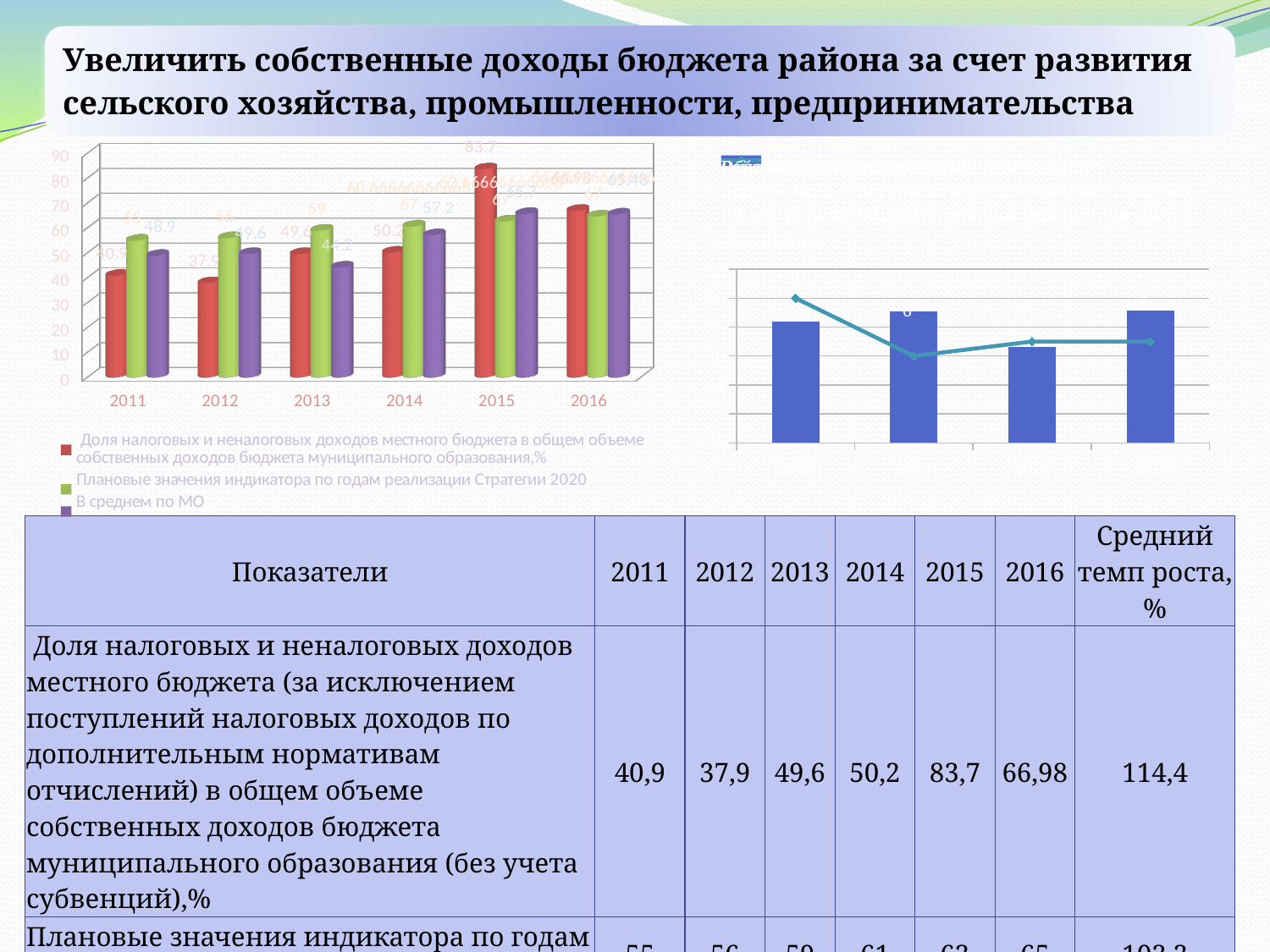
In the left chart, what is the value of the red series for 2015? 83.7 How many series does the legend of the left chart list? 3 In the left chart, what is the difference between the red series values for 2015 and 2014? 33.5 In the left chart, for 2011, which is larger: the red series or the green series? the green series How many years are shown on the x axis of the left chart? 6 In the left chart, in which year is the red series highest? 2015 In the left chart, is the value of the red series for 2015 greater or less than 80? greater In the left chart, what is the value of the red series (Доля налоговых и неналоговых доходов...) for 2011? 40.9 What kind of chart is the left chart? bar chart In the left chart, what is the value of the purple series (В среднем по МО) for 2014? 57.2 In the left chart, what is the value of the green series (Плановые значения индикатора) for 2013? 59 In the left chart, in which year is the red series lowest? 2012